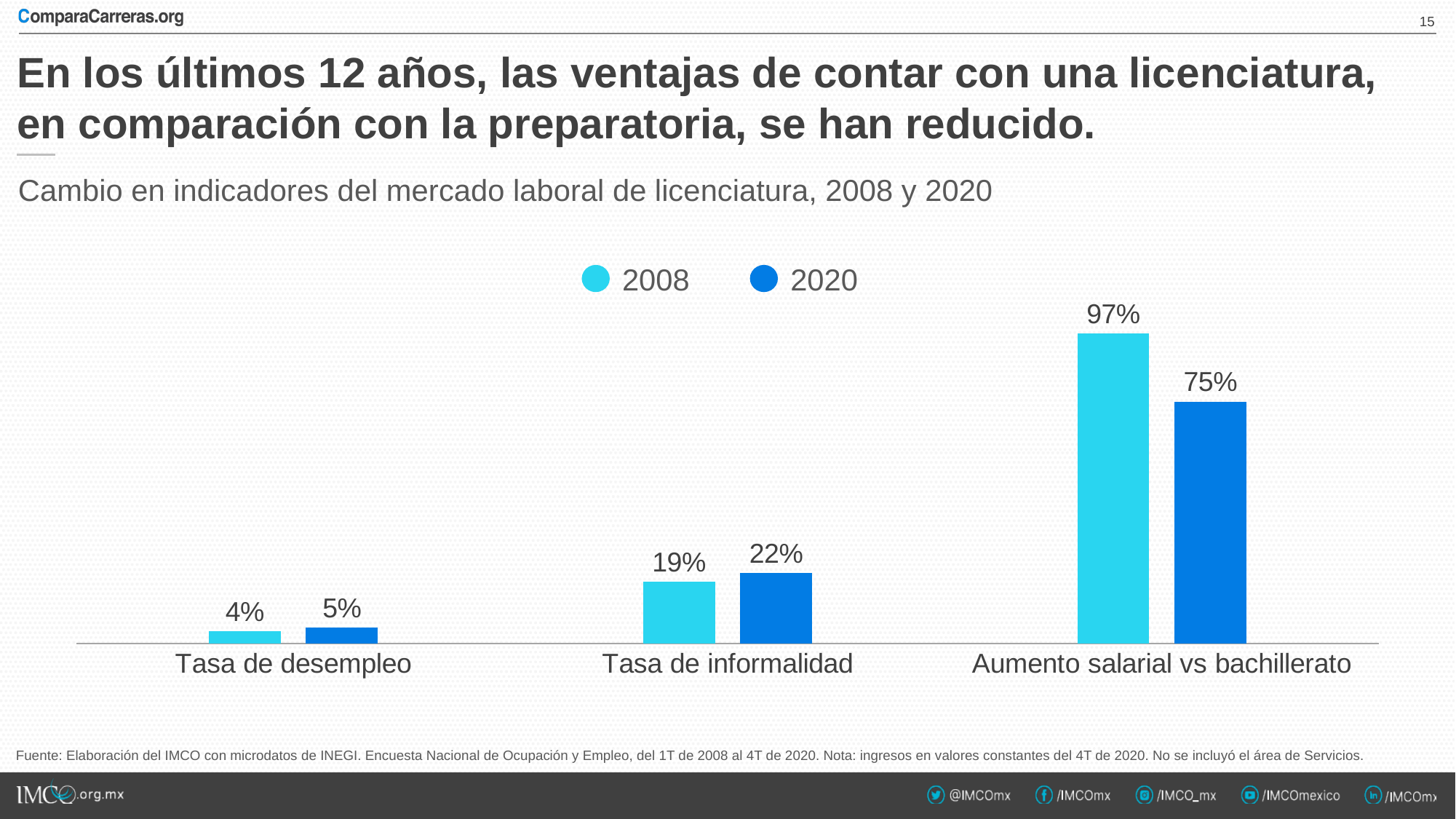
Which years are listed in the chart legend? 2008 and 2020 What is the difference between the 2008 and 2020 values for Aumento salarial vs bachillerato? 22% What is the difference between the 2020 and 2008 values for Tasa de informalidad? 3% Which category has the lowest value in the 2008 series? Tasa de desempleo For Tasa de desempleo, which year has the larger value, 2008 or 2020? 2020 How many series does the legend list? 2 What is the value for Aumento salarial vs bachillerato in 2008? 97% How many categories are shown on the x axis? 3 What kind of chart is shown on the slide? Bar chart What is the value for Tasa de informalidad in 2020? 22% Which category has the highest value in the 2020 series? Aumento salarial vs bachillerato What is the value for Tasa de desempleo in 2008? 4%